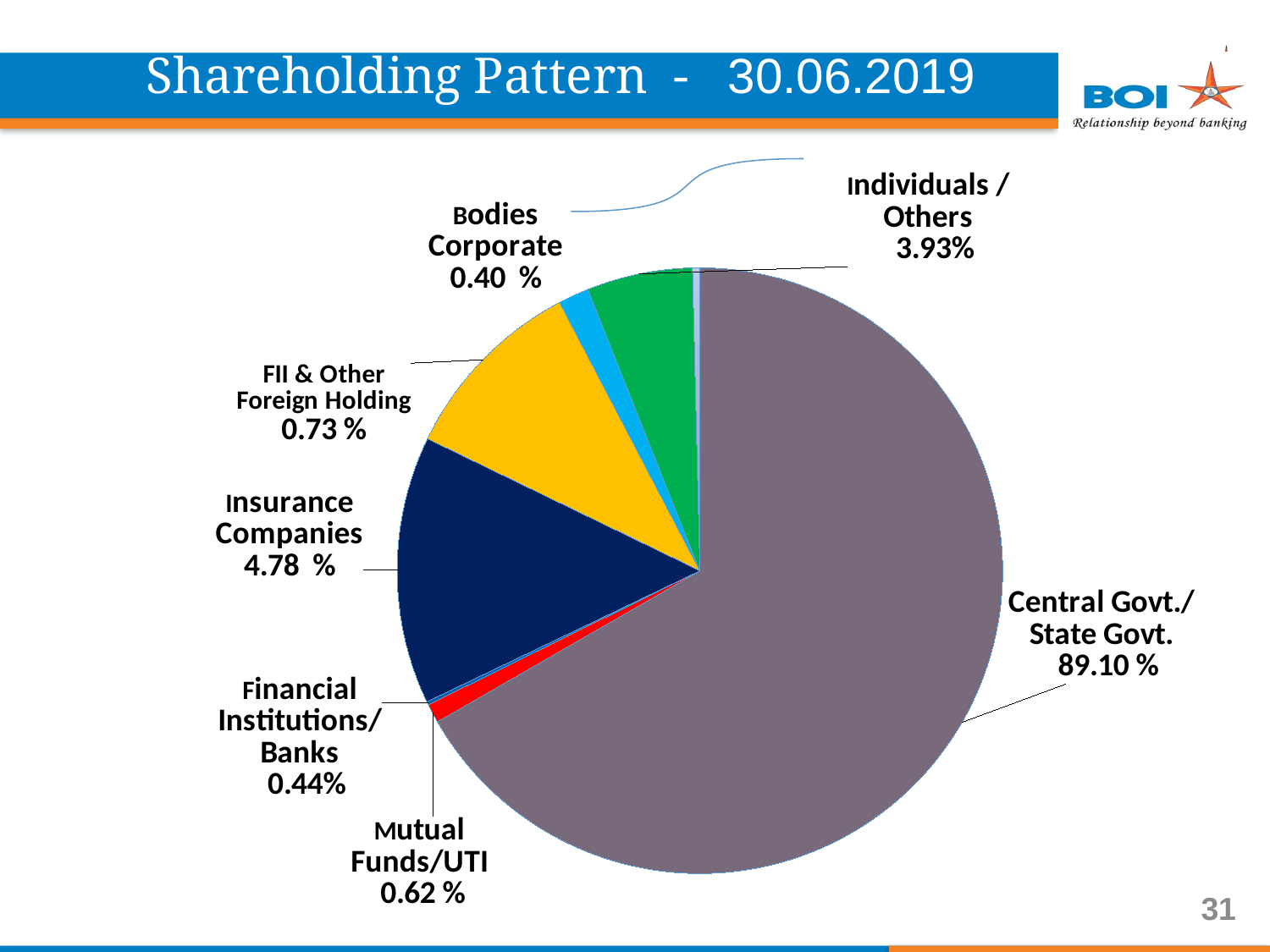
Which category has the smallest slice of the pie? Bodies Corporate How many categories are shown in the pie chart? 7 Which is larger, the share for Mutual Funds/UTI or the share for Financial Institutions/Banks? Mutual Funds/UTI What kind of chart is shown on the slide? Pie chart What is the value shown for Insurance Companies? 4.78 % What is the difference between the Central Govt./State Govt. share and the Insurance Companies share? 84.32 % What share is shown for Mutual Funds/UTI? 0.62 % Which category has the largest slice of the pie? Central Govt./State Govt. What share of the pie does Central Govt./State Govt. hold? 89.10 % What is the title of the slide containing the chart? Shareholding Pattern - 30.06.2019 What percentage is shown for Individuals / Others? 3.93% What is the value for FII & Other Foreign Holding? 0.73 %